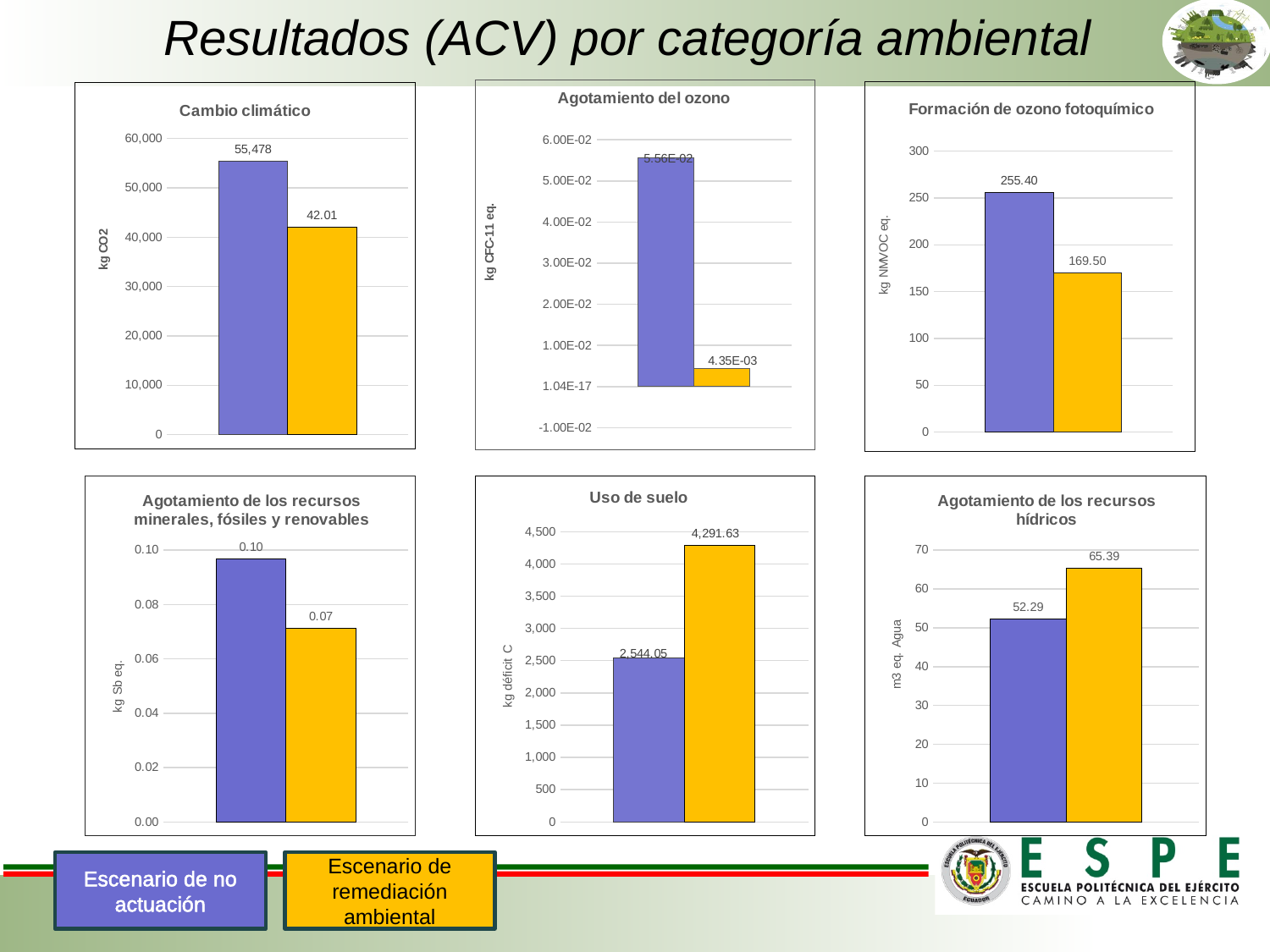
How many charts are shown on the slide? 6 In the 'Uso de suelo' chart, which scenario has the larger value, 'Escenario de no actuación' or 'Escenario de remediación ambiental'? Escenario de remediación ambiental In the 'Agotamiento de los recursos minerales, fósiles y renovables' chart, which scenario has the higher value? Escenario de no actuación In the 'Uso de suelo' chart, what is the value for the 'Escenario de remediación ambiental' (yellow) bar? 4,291.63 In the 'Formación de ozono fotoquímico' chart, what is the value for the 'Escenario de remediación ambiental' (yellow) bar? 169.50 In the 'Agotamiento de los recursos hídricos' chart, what is the difference between the 'Escenario de remediación ambiental' and 'Escenario de no actuación' values? 13.10 In the 'Cambio climático' chart, what is the value for the 'Escenario de no actuación' (blue) bar? 55,478 In the 'Agotamiento del ozono' chart, what is the value for the 'Escenario de remediación ambiental' (yellow) bar? 4.35E-03 In the 'Formación de ozono fotoquímico' chart, what is the value for the 'Escenario de no actuación' (blue) bar? 255.40 In the 'Formación de ozono fotoquímico' chart, what is the difference between the 'Escenario de no actuación' and 'Escenario de remediación ambiental' values? 85.90 In the 'Uso de suelo' chart, what is the value for the 'Escenario de no actuación' (blue) bar? 2,544.05 In the 'Agotamiento de los recursos hídricos' chart, what is the value for the 'Escenario de remediación ambiental' (yellow) bar? 65.39